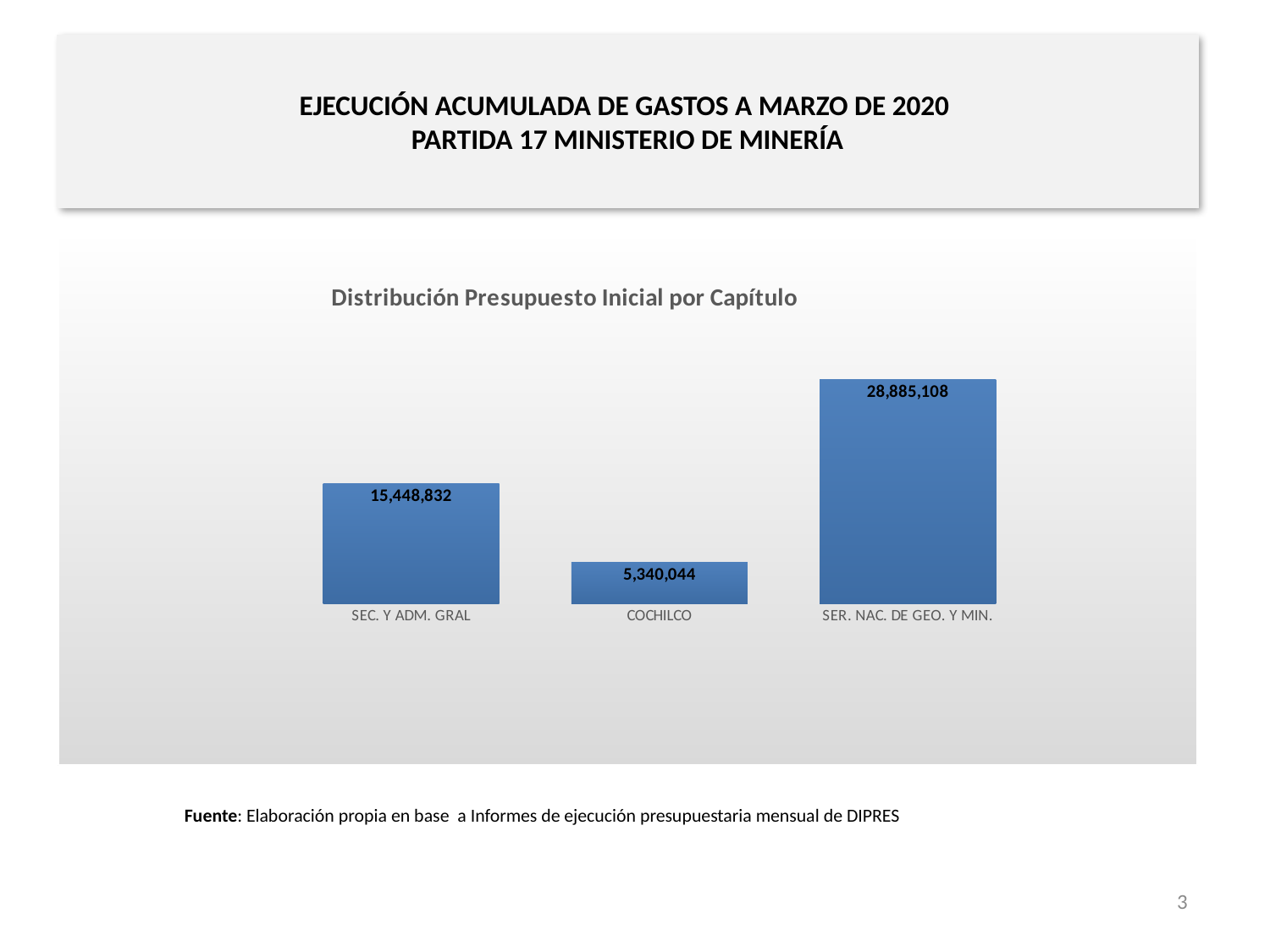
What is the difference between the values for SEC. Y ADM. GRAL and COCHILCO? 10,108,788 What is the value for SER. NAC. DE GEO. Y MIN.? 28,885,108 What kind of chart is shown on the slide? Bar chart Which category has the highest value? SER. NAC. DE GEO. Y MIN. What is the value for COCHILCO? 5,340,044 What is the difference between the values for SER. NAC. DE GEO. Y MIN. and COCHILCO? 23,545,064 Which category has the lowest value? COCHILCO What is the value for SEC. Y ADM. GRAL? 15,448,832 How many categories are shown in the chart? 3 Which is larger, the value for SEC. Y ADM. GRAL or the value for COCHILCO? SEC. Y ADM. GRAL What is the difference between the values for SER. NAC. DE GEO. Y MIN. and SEC. Y ADM. GRAL? 13,436,276 What is the title of the chart? Distribución Presupuesto Inicial por Capítulo